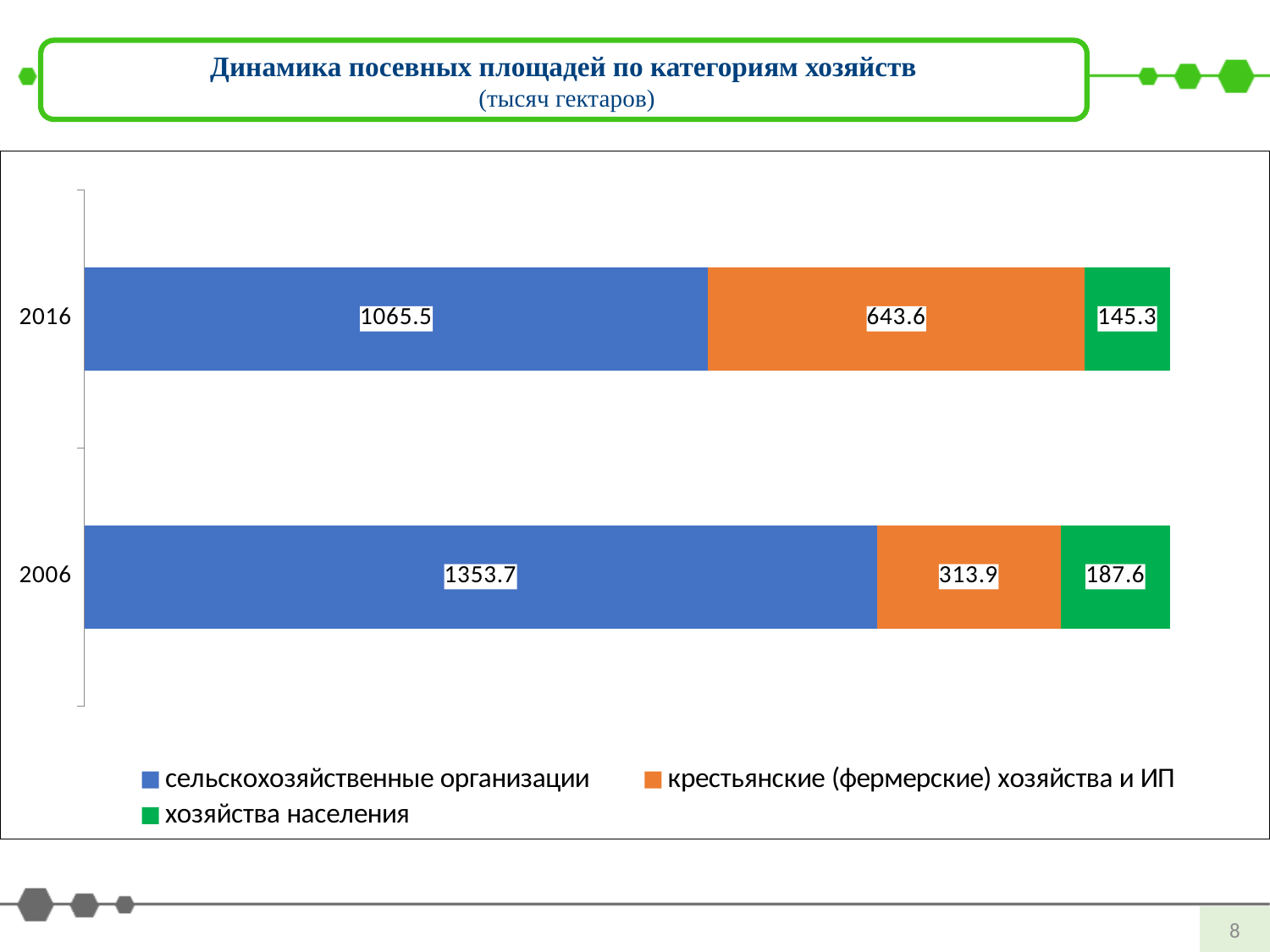
What is the value for сельскохозяйственные организации in 2006? 1353.7 How many series does the legend list? 3 What is the value for хозяйства населения in 2016? 145.3 What kind of chart is shown on the slide? Stacked bar chart What is the value for крестьянские (фермерские) хозяйства и ИП in 2006? 313.9 Which series has the largest value in 2016? сельскохозяйственные организации What is the total of the stacked bar for 2016? 1854.4 What is the value for сельскохозяйственные организации in 2016? 1065.5 Which series has the smallest value in 2006? хозяйства населения What is the difference between the values for крестьянские (фермерские) хозяйства и ИП in 2016 and 2006? 329.7 Which is larger: хозяйства населения in 2006 or in 2016? 2006 What is the difference between the values for сельскохозяйственные организации in 2006 and 2016? 288.2